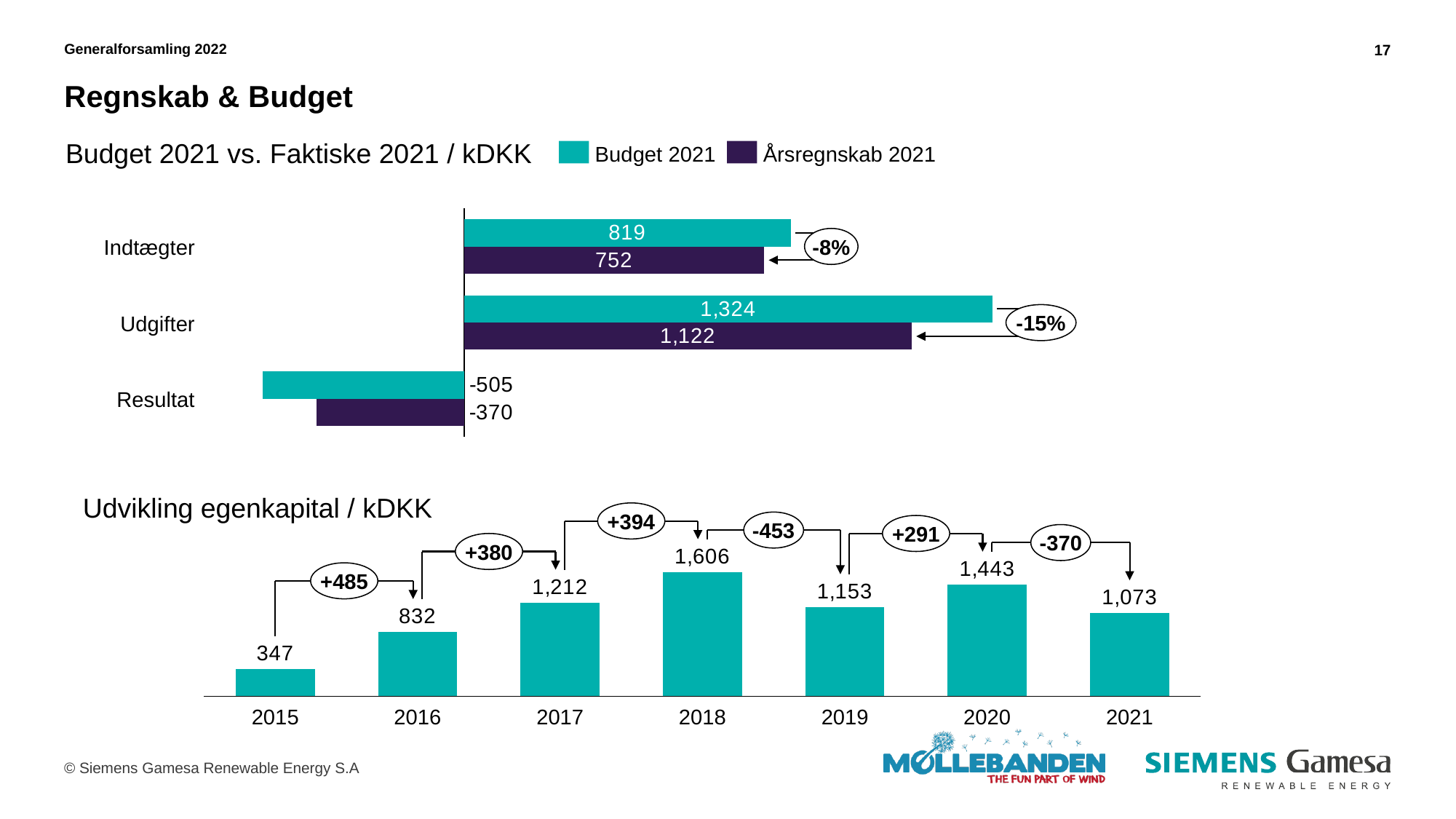
In the 'Budget 2021 vs. Faktiske 2021 / kDKK' chart, how many series does the legend list? 2 What kind of chart is the 'Udvikling egenkapital / kDKK' chart? Bar chart In the 'Budget 2021 vs. Faktiske 2021 / kDKK' chart, what is the Budget 2021 value for Indtægter? 819 In the 'Budget 2021 vs. Faktiske 2021 / kDKK' chart, what is the Årsregnskab 2021 value for Udgifter? 1,122 In the 'Budget 2021 vs. Faktiske 2021 / kDKK' chart, what is the difference between the Budget 2021 and Årsregnskab 2021 values for Udgifter? 202 In the 'Budget 2021 vs. Faktiske 2021 / kDKK' chart, which is larger for Indtægter: Budget 2021 or Årsregnskab 2021? Budget 2021 In the 'Udvikling egenkapital / kDKK' chart, how many years are shown? 7 In the 'Udvikling egenkapital / kDKK' chart, which year has the lowest value? 2015 In the 'Udvikling egenkapital / kDKK' chart, which year has the highest value? 2018 In the 'Udvikling egenkapital / kDKK' chart, what is the value for 2018? 1,606 In the 'Budget 2021 vs. Faktiske 2021 / kDKK' chart, what is the Årsregnskab 2021 value for Resultat? -370 In the 'Udvikling egenkapital / kDKK' chart, what is the difference between the 2020 and 2021 values? 370